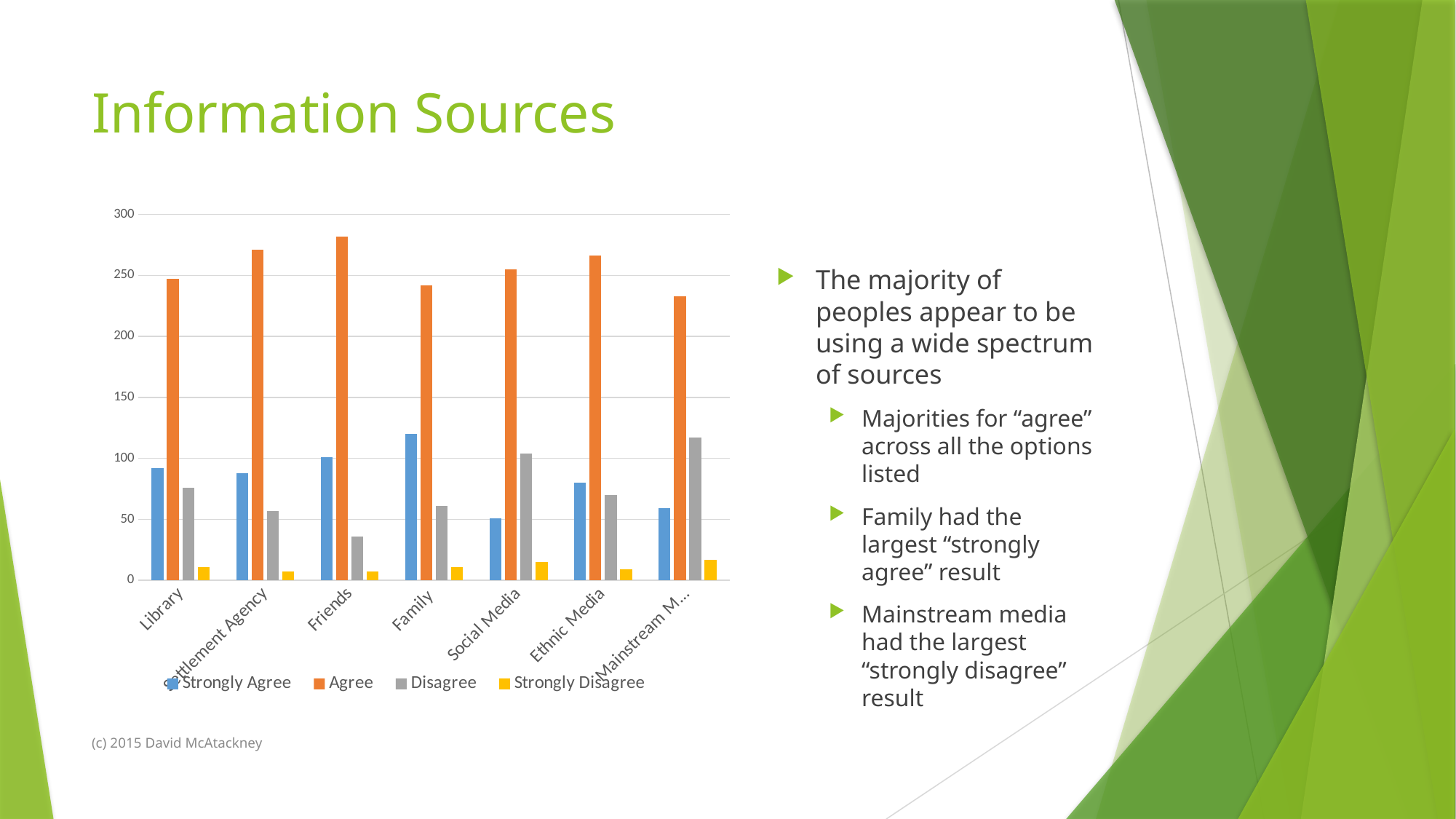
How many series does the chart's legend list? 4 Which colour represents the Agree series in the chart? orange Is the Agree value for Library greater or less than 200? greater Is the Disagree value for Friends greater or less than 50? less Which category has the lowest Disagree value? Friends Which category has the highest Agree value? Friends What kind of chart is shown on the slide? bar chart Is the Strongly Agree value for Family greater or less than 100? greater Which is larger, the Disagree value for Library or the Disagree value for Family? Library How many categories are shown along the x axis of the chart? 7 Which category has the highest Strongly Agree value? Family What is the title of the slide containing the chart? Information Sources